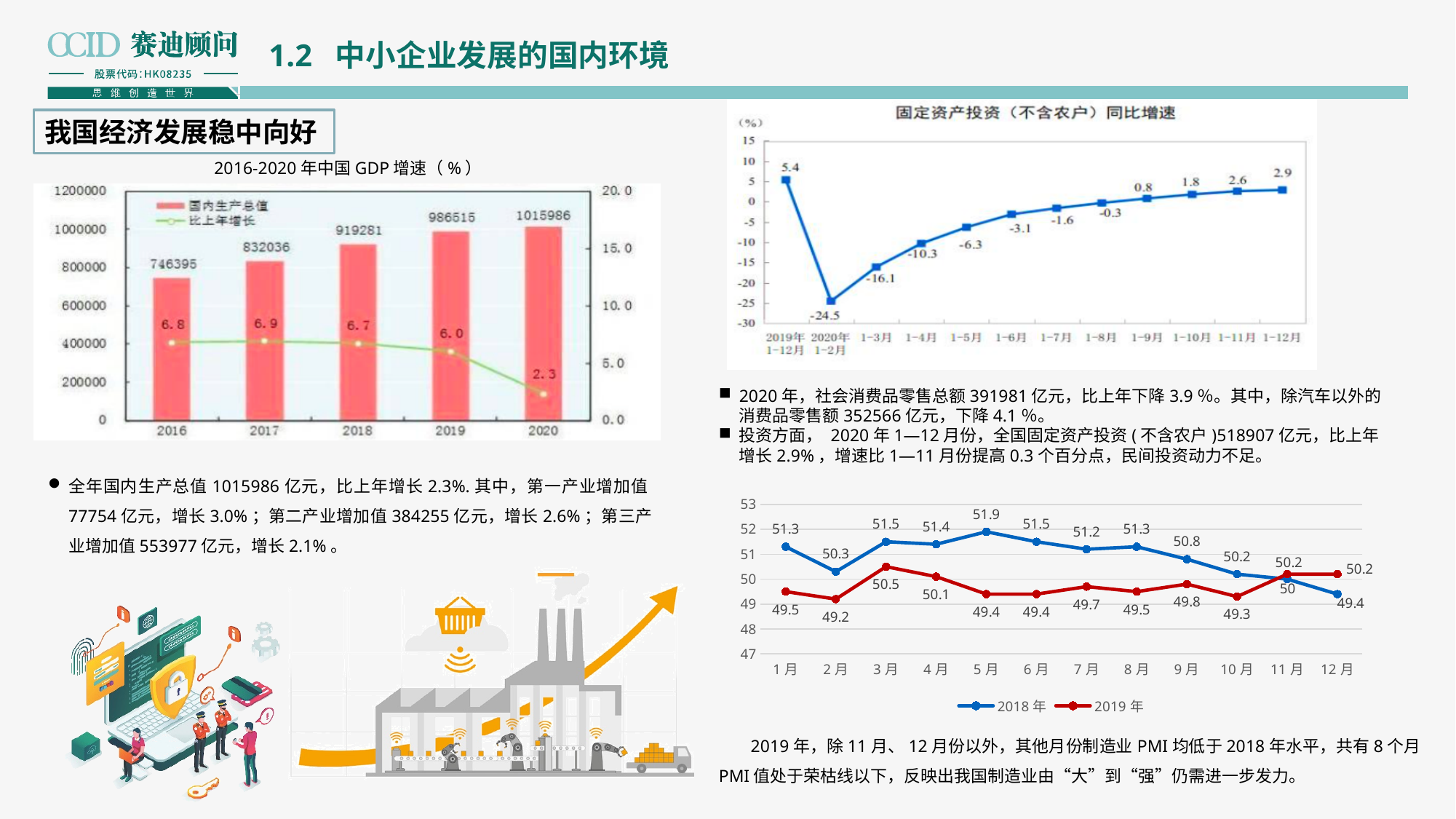
In the PMI chart at the bottom right, what is the difference between the 2018年 and 2019年 values for 12月? 0.8 In the 2016-2020 China GDP chart on the left, what is the growth rate (比上年增长) for 2017? 6.9 In the 2016-2020 China GDP chart on the left, what is the difference between the GDP values for 2019 and 2018? 67234 In the 固定资产投资（不含农户）同比增速 chart at the top right, what kind of chart is it? line chart In the PMI chart at the bottom right, what is the 2018年 value for 5月? 51.9 In the 固定资产投资（不含农户）同比增速 chart at the top right, what is the value for 1-9月? 0.8 In the 2016-2020 China GDP chart on the left, how many series does the legend list? 2 In the 固定资产投资（不含农户）同比增速 chart at the top right, what is the value for 2020年1-2月? -24.5 In the PMI chart at the bottom right, which is larger for 2月: the 2018年 value or the 2019年 value? 2018年 In the 2016-2020 China GDP chart on the left, what is the GDP value (国内生产总值) for 2020? 1015986 In the 固定资产投资（不含农户）同比增速 chart at the top right, how many data points are plotted? 12 In the 2016-2020 China GDP chart on the left, which year has the lowest growth rate? 2020